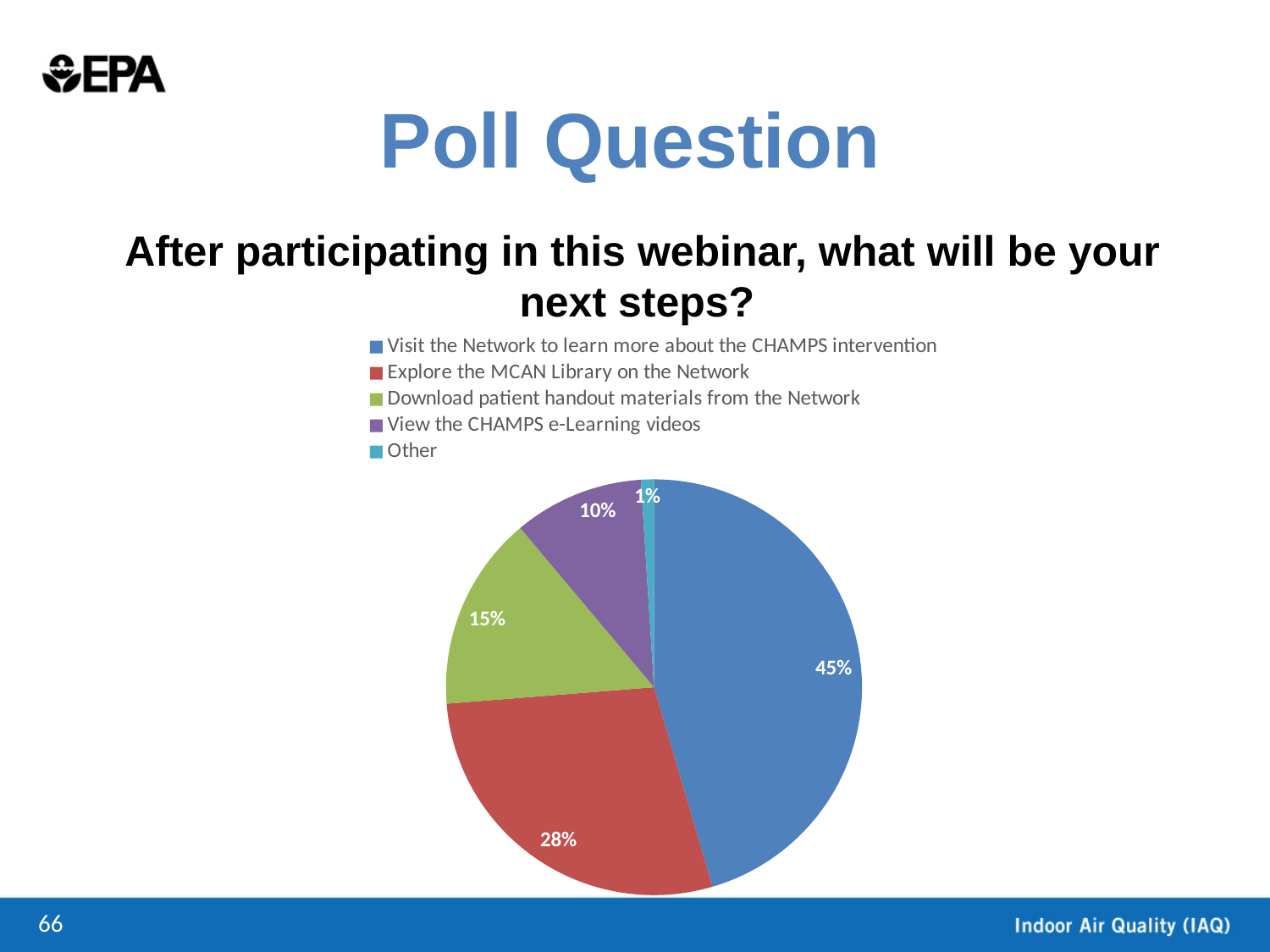
How many response options (slices) does the pie chart show? 5 What kind of chart is shown on the slide? pie chart What is the difference in percentage points between "Visit the Network to learn more about the CHAMPS intervention" and "Explore the MCAN Library on the Network"? 17 percentage points Which response option has the smallest share of the pie? Other Which is larger: the share for "Download patient handout materials from the Network" or the share for "View the CHAMPS e-Learning videos"? Download patient handout materials from the Network Which response option has the largest share of the pie? Visit the Network to learn more about the CHAMPS intervention What share of responses is for "Download patient handout materials from the Network"? 15% What share of responses is for "View the CHAMPS e-Learning videos"? 10% What colour is the slice for "Explore the MCAN Library on the Network"? red What share of responses is for "Other"? 1% What share of responses is for "Explore the MCAN Library on the Network"? 28% What share of responses is for "Visit the Network to learn more about the CHAMPS intervention"? 45%